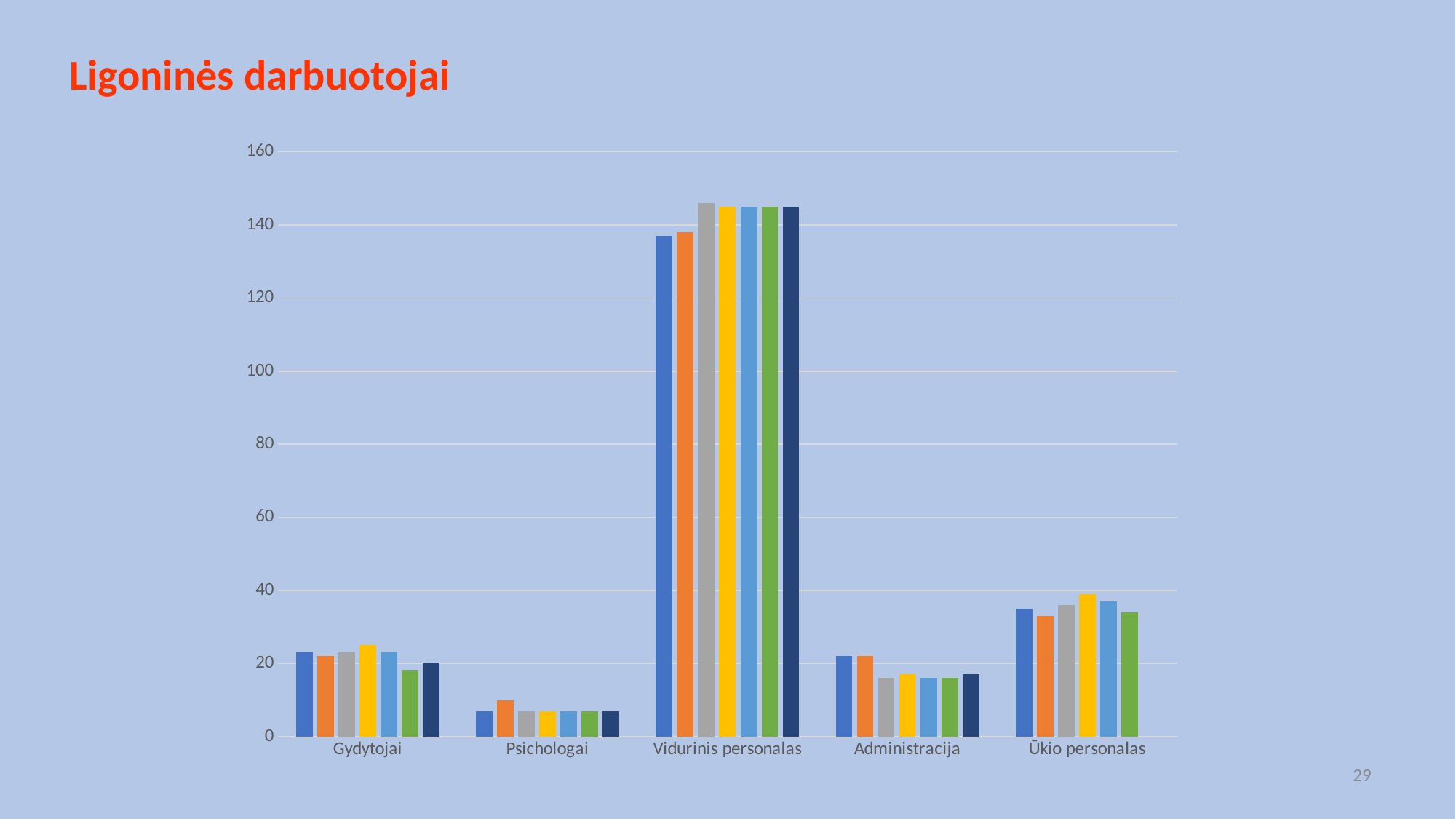
How many categories are shown on the x axis of the chart? 5 What is the highest value shown on the vertical axis of the chart? 160 Are the values for Ūkio personalas greater or less than 20? greater Which category has the highest bars in the chart? Vidurinis personalas Which category has larger values, Gydytojai or Psichologai? Gydytojai Which category has the lowest bars in the chart? Psichologai What kind of chart is shown on the slide? bar chart What is the title of the chart? Ligoninės darbuotojai Are the values for Psichologai greater or less than 20? less Are the values for Vidurinis personalas greater or less than 120? greater Which category has larger values, Ūkio personalas or Administracija? Ūkio personalas